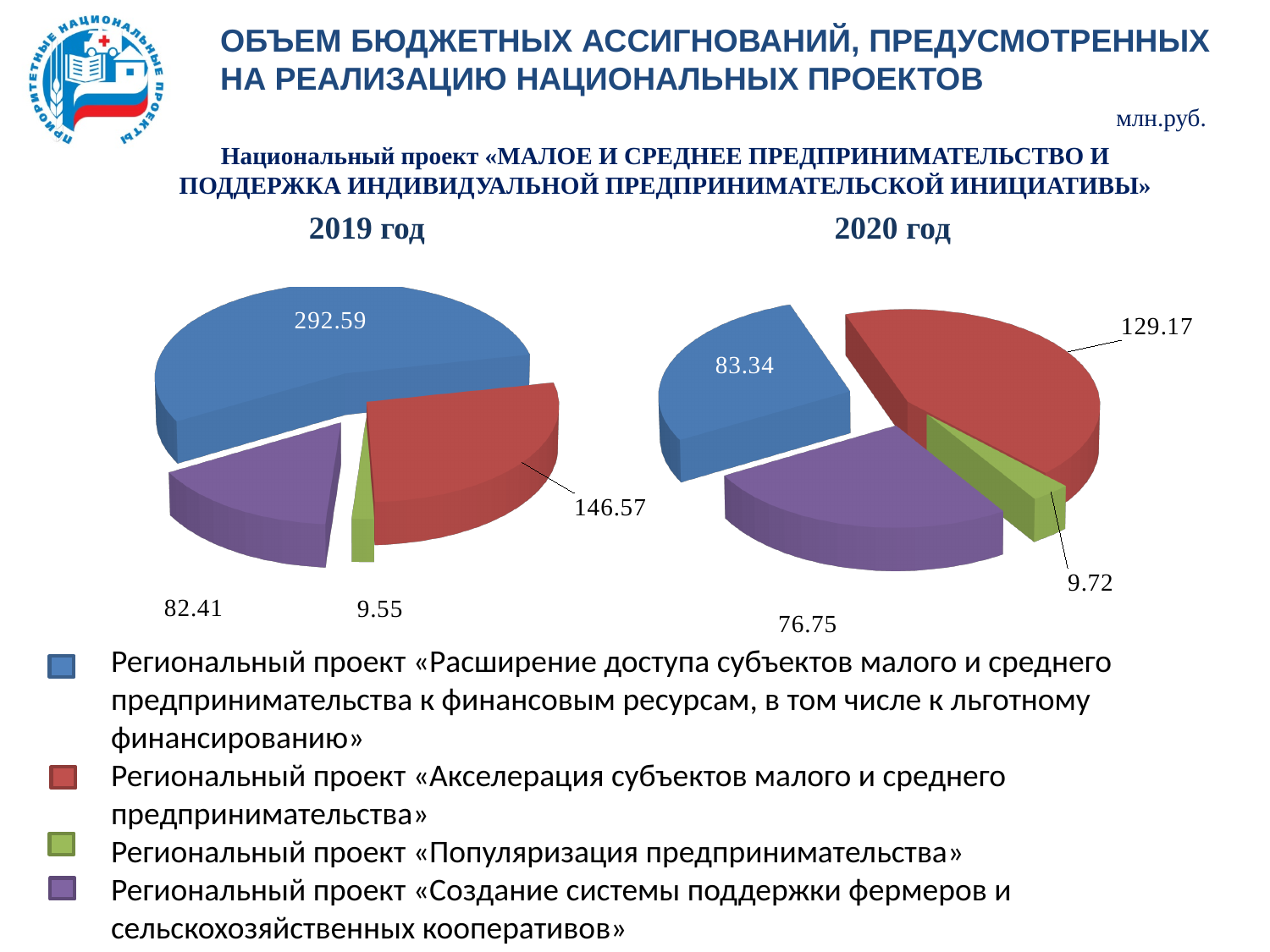
In the 2020 год chart, what is the value for the regional project «Создание системы поддержки фермеров и сельскохозяйственных кооперативов»? 76.75 In the 2019 год chart, what is the value for the regional project «Расширение доступа субъектов малого и среднего предпринимательства к финансовым ресурсам...»? 292.59 In the 2020 год chart, which regional project has the smallest slice? «Популяризация предпринимательства» Which colour represents the regional project «Популяризация предпринимательства» in the legend? Green In the 2019 год chart, what is the difference between the values for «Расширение доступа...» (292.59) and «Акселерация...» (146.57)? 146.02 How many slices does each pie chart have? 4 In the 2019 год chart, what is the value for the regional project «Популяризация предпринимательства»? 9.55 In the 2020 год chart, what is the value for the regional project «Акселерация субъектов малого и среднего предпринимательства»? 129.17 By how much did the value for «Расширение доступа субъектов малого и среднего предпринимательства к финансовым ресурсам...» decrease from the 2019 год chart to the 2020 год chart? 209.25 In the 2019 год chart, which regional project has the largest slice? «Расширение доступа субъектов малого и среднего предпринимательства к финансовым ресурсам, в том числе к льготному финансированию» In the 2020 год chart, which is larger: the value for «Акселерация субъектов малого и среднего предпринимательства» or for «Расширение доступа субъектов малого и среднего предпринимательства к финансовым ресурсам...»? «Акселерация субъектов малого и среднего предпринимательства» What type of charts are shown on the slide? Pie charts